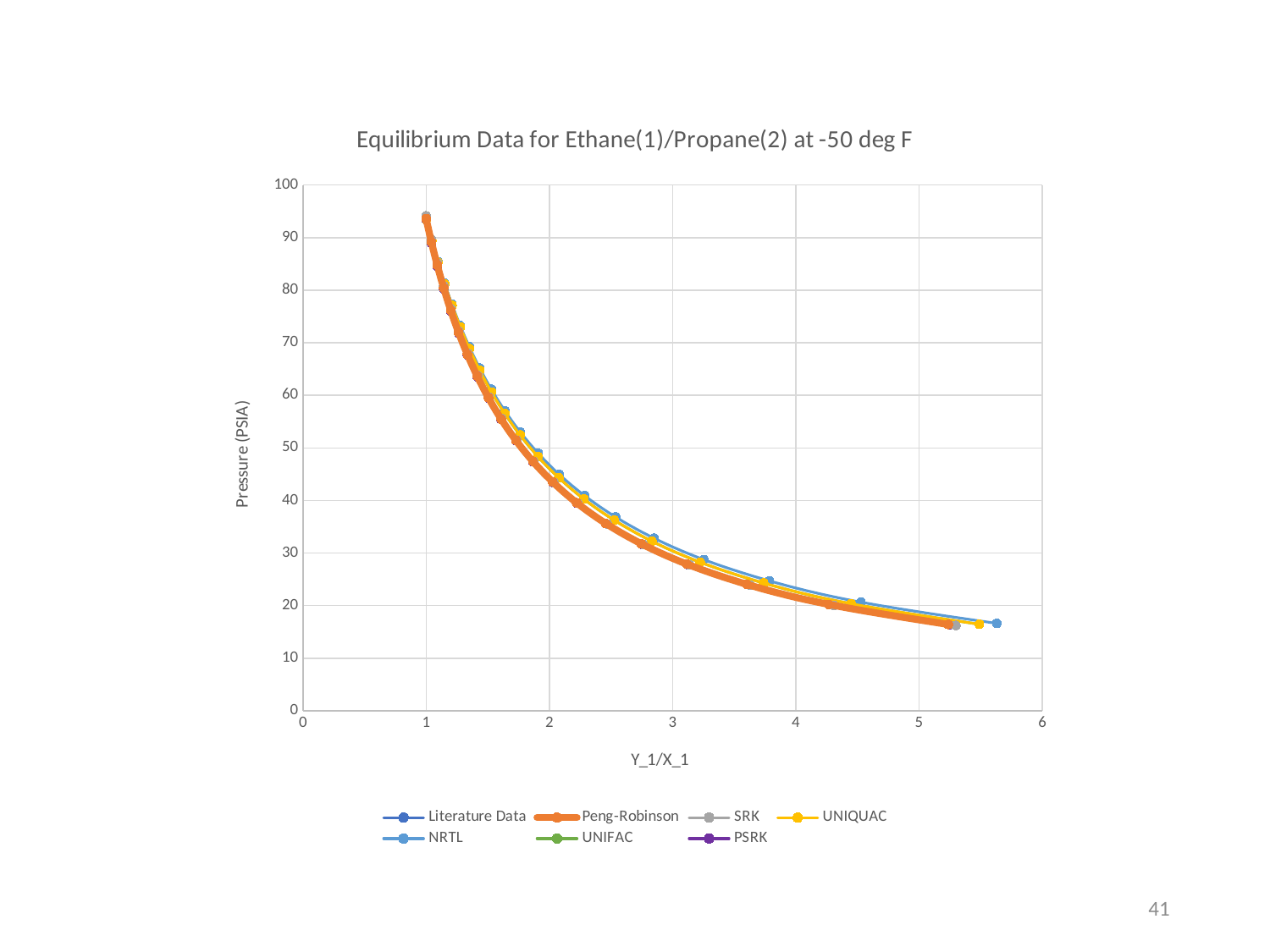
Is the pressure at the rightmost data points (Y_1/X_1 above 5) greater or less than 20? less How many series does the legend list? 7 Which is larger: the pressure at Y_1/X_1 = 1 or the pressure at Y_1/X_1 = 5? Y_1/X_1 = 1 What is the title of the chart? Equilibrium Data for Ethane(1)/Propane(2) at -50 deg F Does the pressure rise or fall as Y_1/X_1 increases along the x axis? Fall Is the pressure at a Y_1/X_1 value of 4 greater or less than 30? less Is the pressure at a Y_1/X_1 value of 2 greater or less than 40? greater What type of chart is shown on the slide? Line chart What is the maximum value shown on the Pressure (PSIA) axis? 100 What is the label of the vertical axis? Pressure (PSIA)